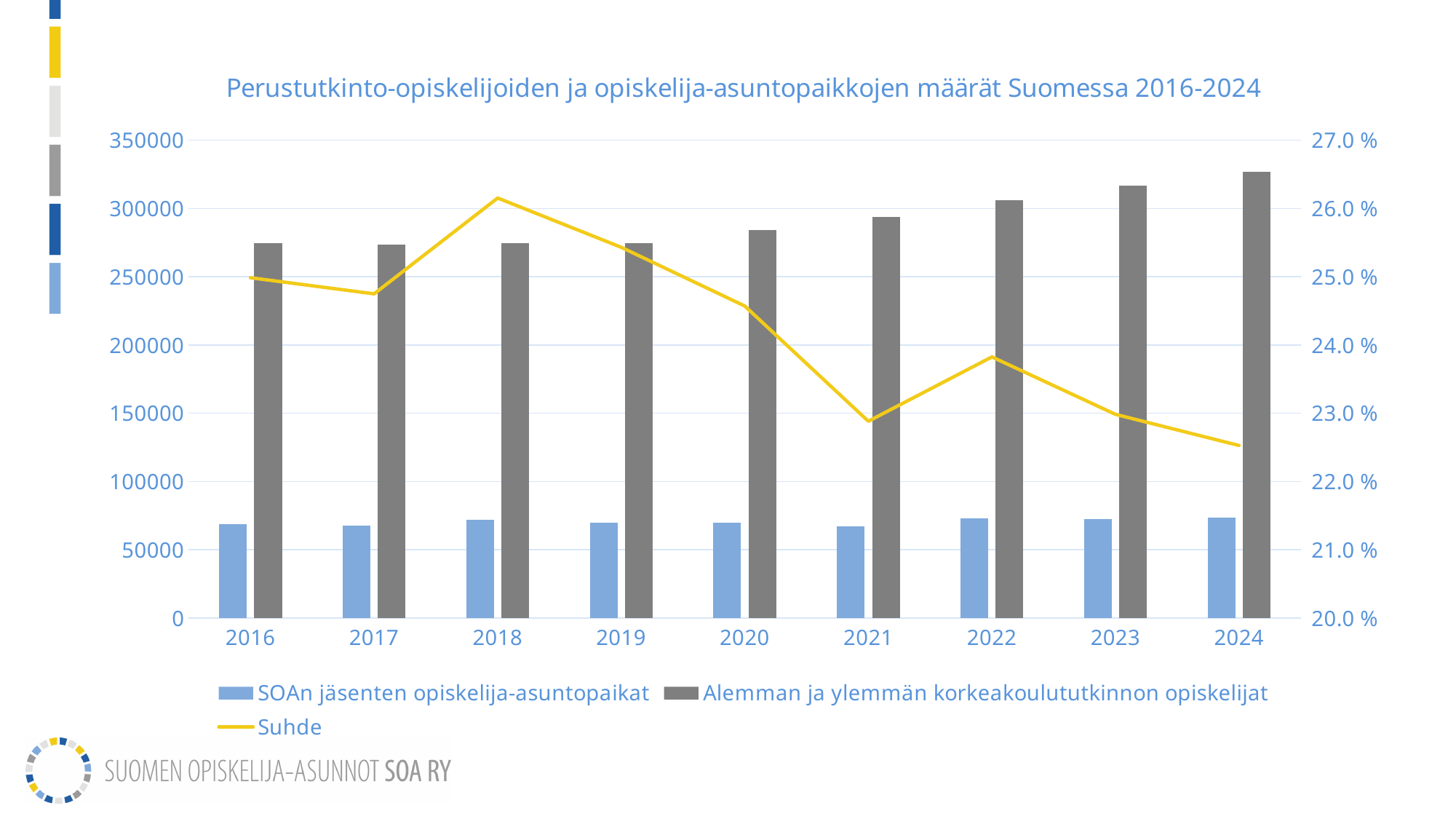
Is the value for Alemman ja ylemmän korkeakoulututkinnon opiskelijat in 2016 greater or less than 300000? less In which year does the Suhde line reach its highest value? 2018 What is the title of the chart? Perustutkinto-opiskelijoiden ja opiskelija-asuntopaikkojen määrät Suomessa 2016-2024 How many series does the legend list? 3 What kind of chart is this? Combined bar and line chart Which is larger: the Suhde value in 2018 or in 2021? 2018 How many years are shown on the x axis? 9 Is the value for Alemman ja ylemmän korkeakoulututkinnon opiskelijat in 2024 greater or less than 300000? greater Do the values for Alemman ja ylemmän korkeakoulututkinnon opiskelijat generally rise or fall from 2016 to 2024? rise In which year is the value for Alemman ja ylemmän korkeakoulututkinnon opiskelijat highest? 2024 Is the value for SOAn jäsenten opiskelija-asuntopaikat in 2018 greater or less than 100000? less